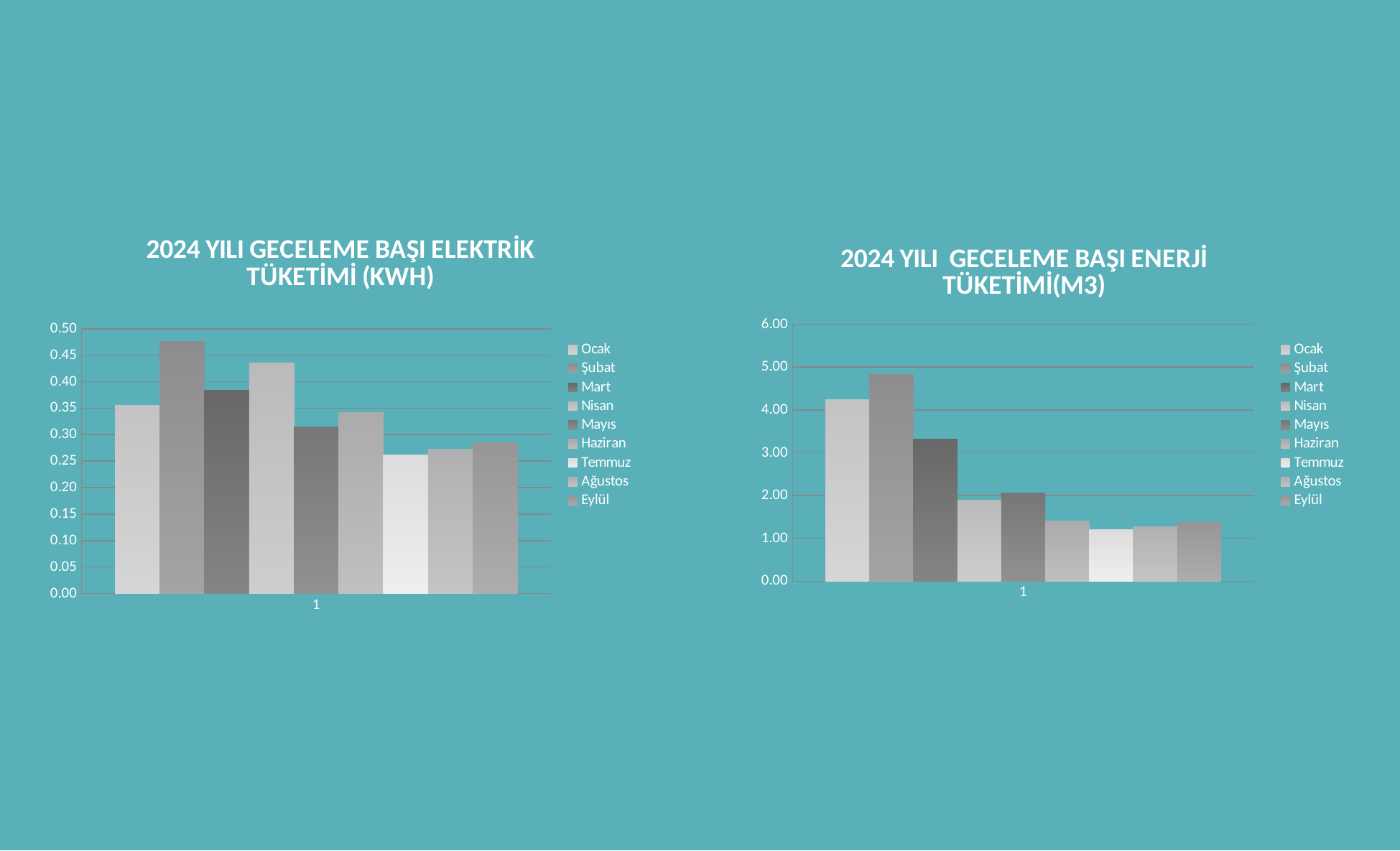
In the chart titled '2024 YILI GECELEME BAŞI ENERJİ TÜKETİMİ(M3)', which is larger, the value for Ocak or the value for Mart? Ocak In the chart titled '2024 YILI GECELEME BAŞI ELEKTRİK TÜKETİMİ (KWH)', is the value for Şubat greater or less than 0.45? greater What kind of chart is the chart titled '2024 YILI GECELEME BAŞI ENERJİ TÜKETİMİ(M3)'? bar chart What is the first entry in the legend of the right chart? Ocak In the chart titled '2024 YILI GECELEME BAŞI ELEKTRİK TÜKETİMİ (KWH)', is the value for Mayıs greater or less than 0.35? less In the chart titled '2024 YILI GECELEME BAŞI ELEKTRİK TÜKETİMİ (KWH)', which is larger, the value for Nisan or the value for Mart? Nisan In the chart titled '2024 YILI GECELEME BAŞI ELEKTRİK TÜKETİMİ (KWH)', which month has the highest bar? Şubat In the chart titled '2024 YILI GECELEME BAŞI ELEKTRİK TÜKETİMİ (KWH)', is the value for Nisan greater or less than 0.40? greater In the chart titled '2024 YILI GECELEME BAŞI ENERJİ TÜKETİMİ(M3)', which month has the highest bar? Şubat How many series does the legend of the left chart list? 9